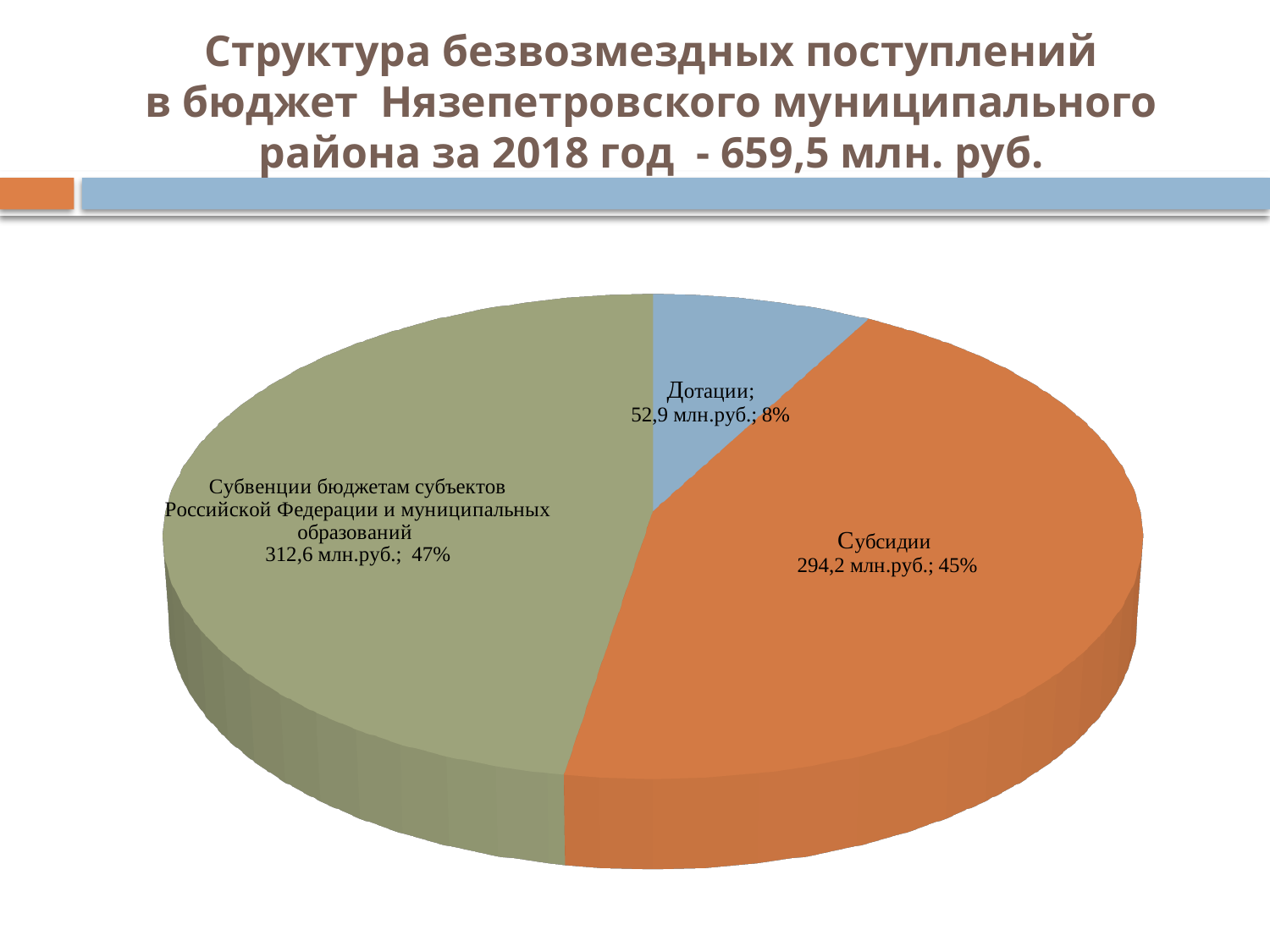
What kind of chart is shown on the slide? pie chart What colour is the Субсидии slice? orange What share of the pie does Дотации represent? 8% How many slices does the pie chart have? 3 What is the difference between the values for Субвенции and Субсидии? 18,4 млн.руб. What is the value for Субсидии? 294,2 млн.руб. Which category has the smallest slice? Дотации Which is larger, Субсидии or Дотации? Субсидии Which category has the largest slice? Субвенции бюджетам субъектов Российской Федерации и муниципальных образований What share of the pie does Субсидии represent? 45% What is the value for Дотации? 52,9 млн.руб. What is the value for Субвенции бюджетам субъектов Российской Федерации и муниципальных образований? 312,6 млн.руб.